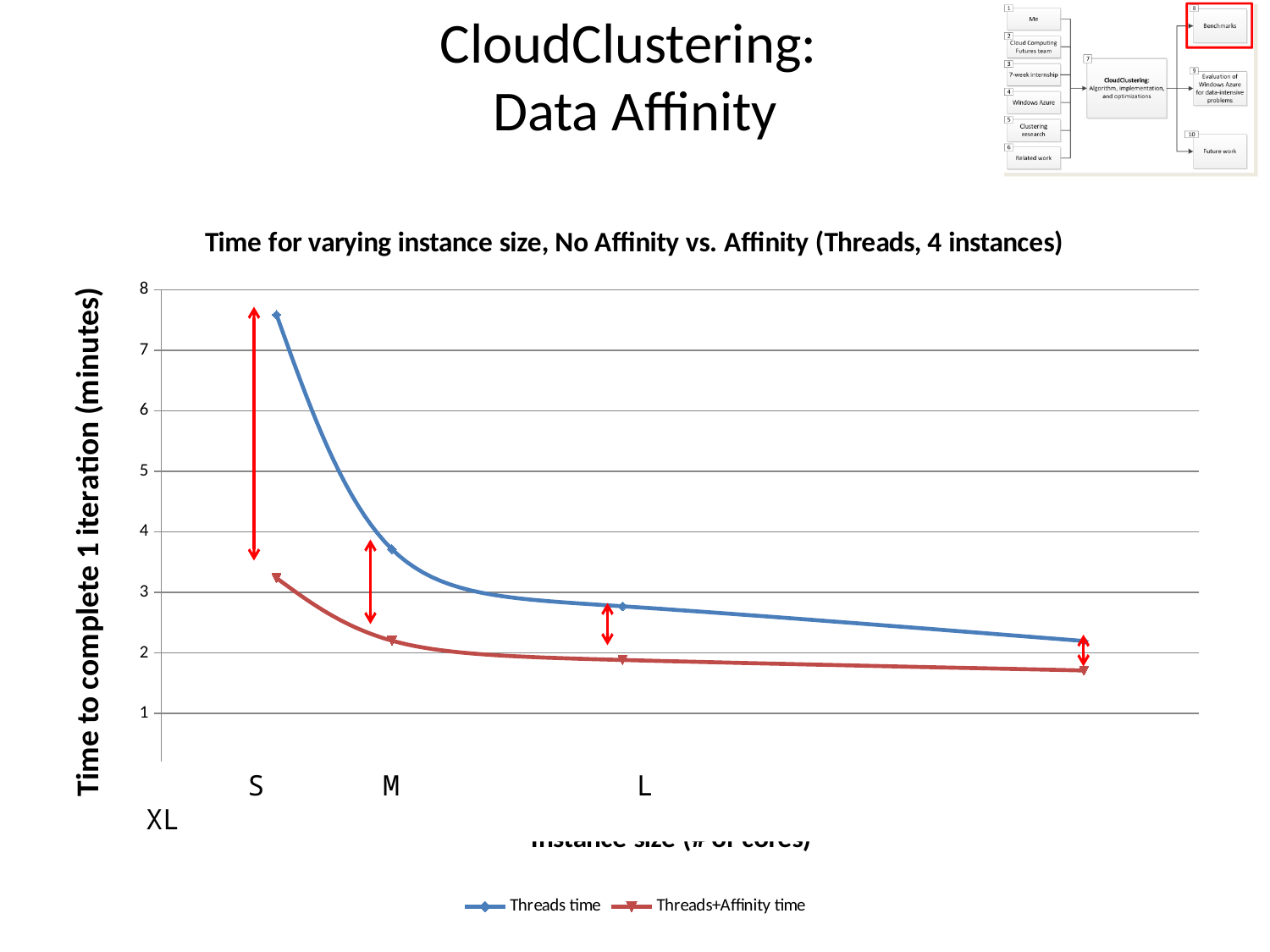
Is the Threads time for instance size M greater or less than 4? less How many instance sizes are plotted along the x axis? 4 What is the title of the chart? Time for varying instance size, No Affinity vs. Affinity (Threads, 4 instances) What kind of chart is shown on the slide? line chart How many series does the legend list? 2 Which instance size has the lowest Threads+Affinity time? XL At instance size S, which series has the larger value, Threads time or Threads+Affinity time? Threads time What are the two series named in the legend? Threads time and Threads+Affinity time Which instance size has the highest Threads time? S Is the Threads time for instance size S greater or less than 7? greater Is the Threads+Affinity time for instance size XL greater or less than 2? less Does the Threads time rise or fall as instance size increases from S to XL? fall